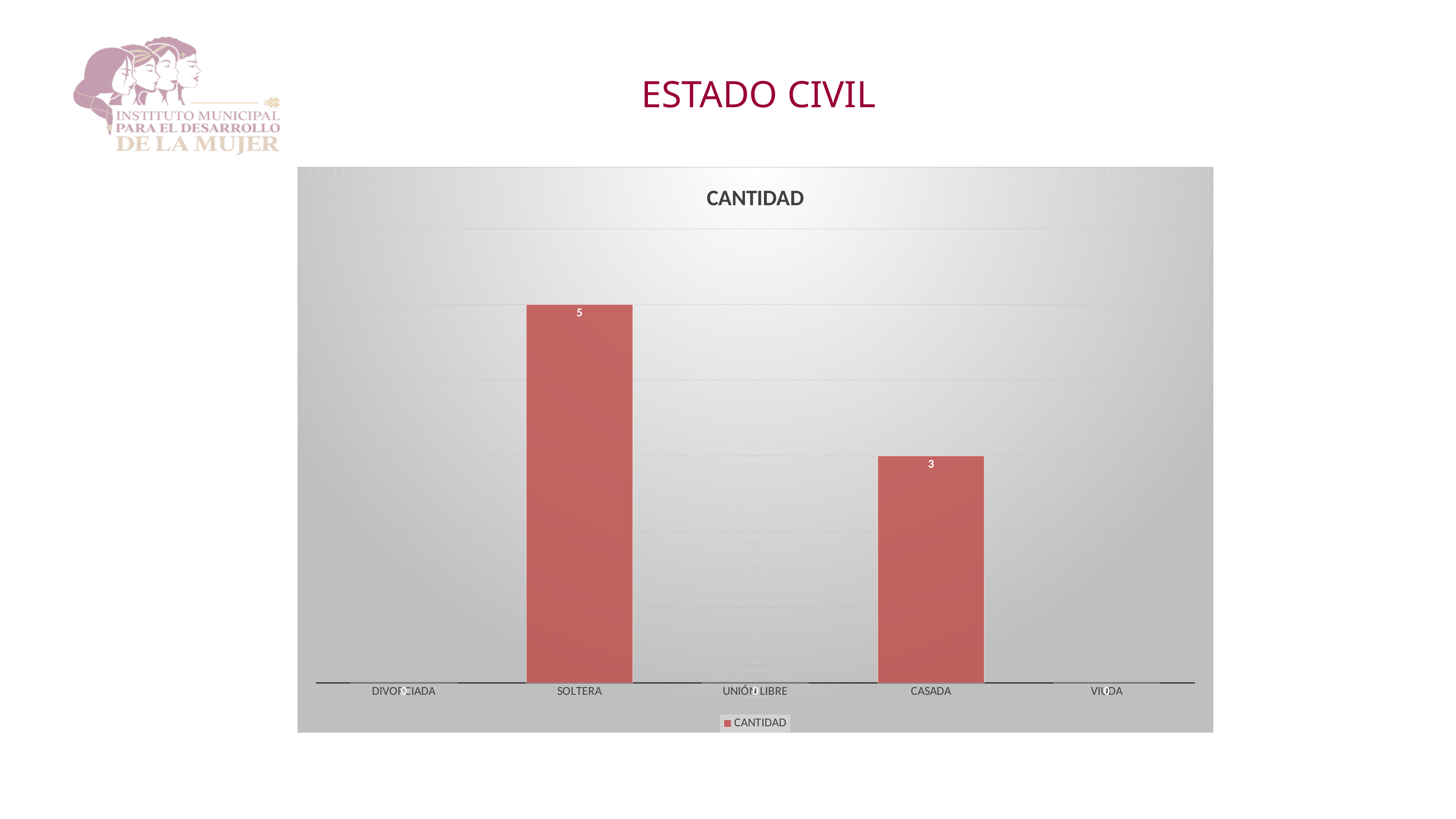
What is the value for SOLTERA? 5 How many series does the legend list? 1 What kind of chart is shown on the slide? bar chart What is the value for VIUDA? 0 What is the value for DIVORCIADA? 0 Which is larger, the value for SOLTERA or the value for CASADA? SOLTERA What is the value for CASADA? 3 What is the difference between the values for SOLTERA and CASADA? 2 What is the name of the series listed in the legend? CANTIDAD How many categories are shown on the x axis? 5 Which category has the highest value? SOLTERA What is the title of the chart? CANTIDAD